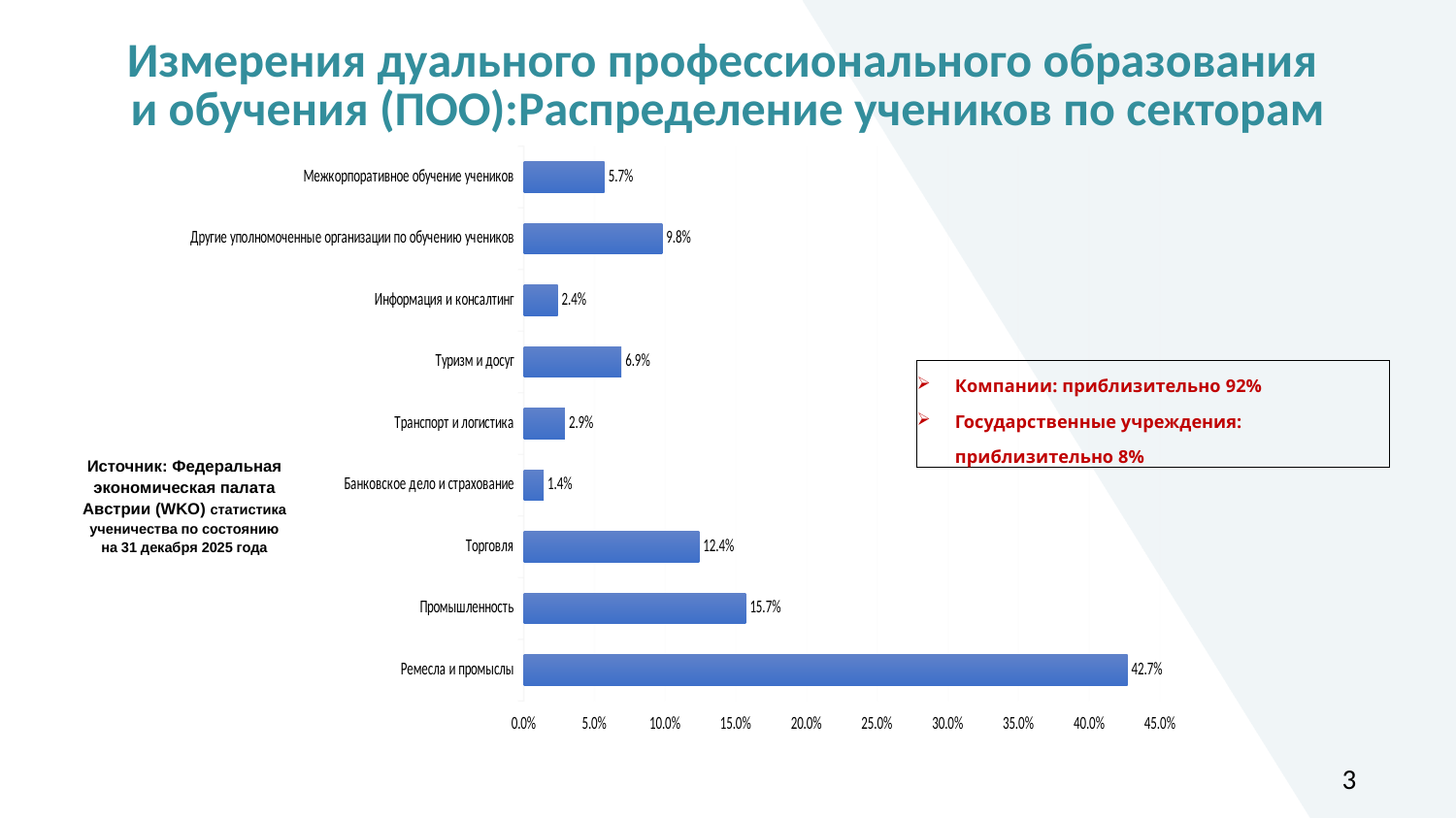
What kind of chart is shown on the slide? bar chart What is the value for Банковское дело и страхование? 1.4% What is the difference between the values for Промышленность and Торговля? 3.3% What is the value for Торговля? 12.4% What is the value for Другие уполномоченные организации по обучению учеников? 9.8% What is the value for Транспорт и логистика? 2.9% Is the value for Ремесла и промыслы greater or less than 40.0%? greater How many categories are shown in the chart? 9 Which category has the highest value? Ремесла и промыслы Which category has the lowest value? Банковское дело и страхование What is the value for Ремесла и промыслы? 42.7% Which is larger, the value for Туризм и досуг or the value for Межкорпоративное обучение учеников? Туризм и досуг